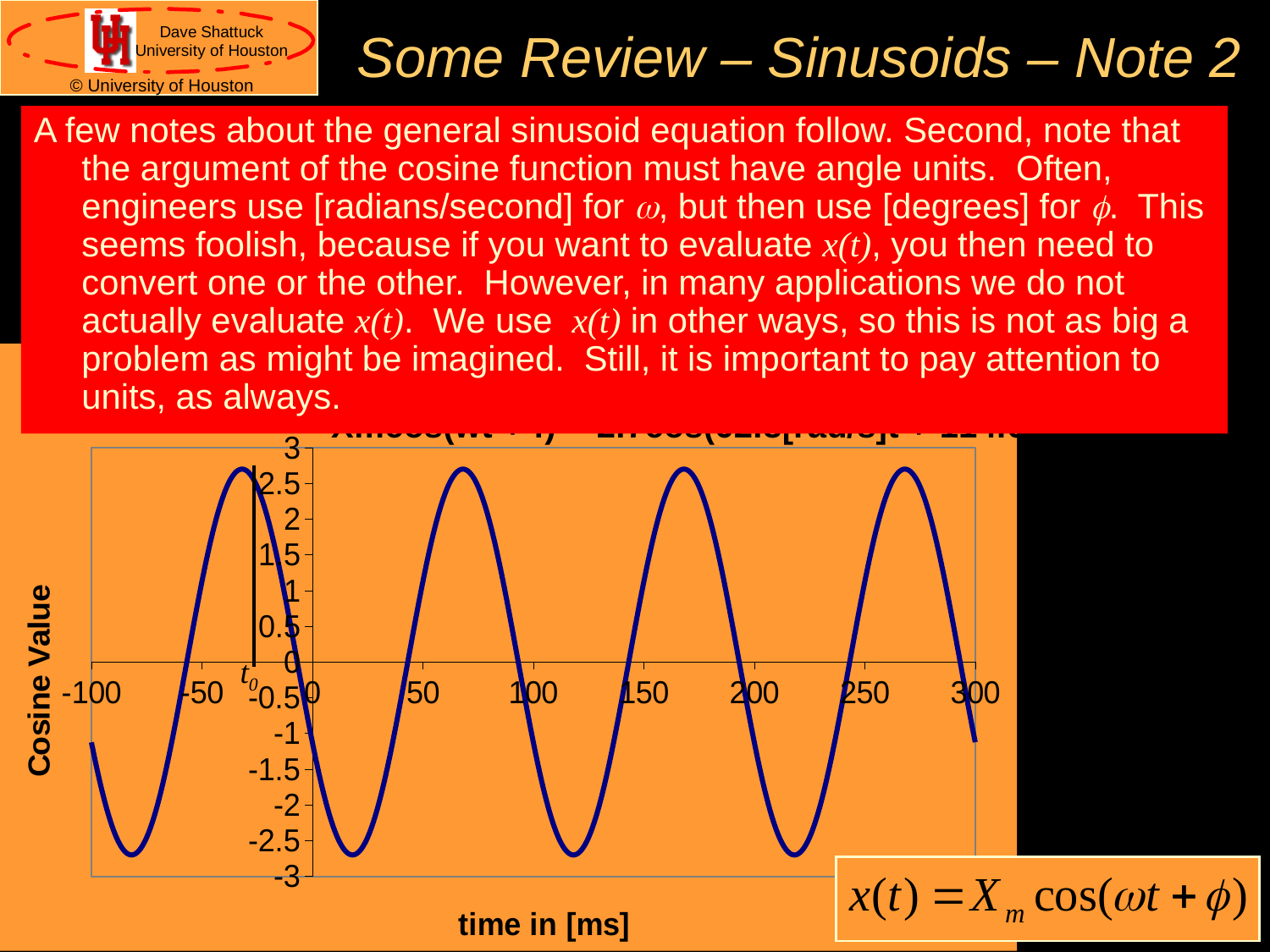
How many troughs (minima) of the cosine curve are visible on the chart? 4 Immediately after time -100 ms, does the plotted curve rise or fall? fall Is the minimum value of the plotted cosine curve greater or less than -2.5? less Is the peak value of the plotted cosine curve greater or less than 2.5? greater How many peaks (maxima) of the cosine curve are visible on the chart? 4 What is the label of the horizontal axis of the chart? time in [ms] How many data series are plotted on the chart? 1 Is the peak value of the plotted cosine curve greater or less than 3? less Immediately after time 0 ms, does the plotted curve rise or fall? fall What kind of chart is shown on the slide? line chart What is the label of the vertical axis of the chart? Cosine Value